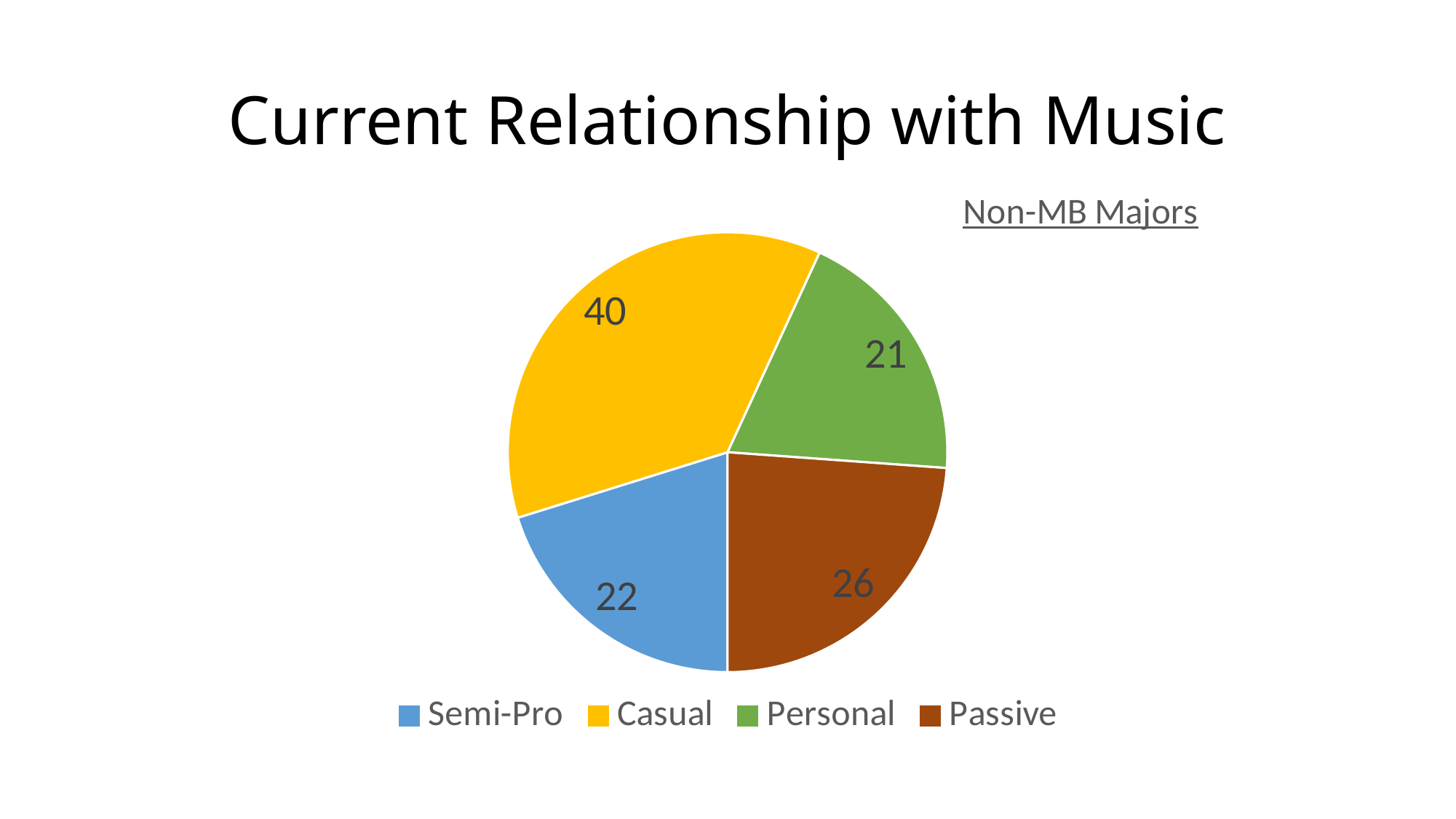
What is the difference between the values for Casual and Passive? 14 What is the value for Casual in the pie chart? 40 Which category has the largest slice of the pie chart? Casual What type of chart is shown on the slide? pie chart What is the value for Semi-Pro in the pie chart? 22 How many categories does the pie chart show? 4 Which category has the smallest slice of the pie chart? Personal What is the value for Passive in the pie chart? 26 What is the value for Personal in the pie chart? 21 Which is larger, the value for Semi-Pro or the value for Passive? Passive What is the total of all the slices in the pie chart? 109 Which group does the label above the pie chart say the data is for? Non-MB Majors